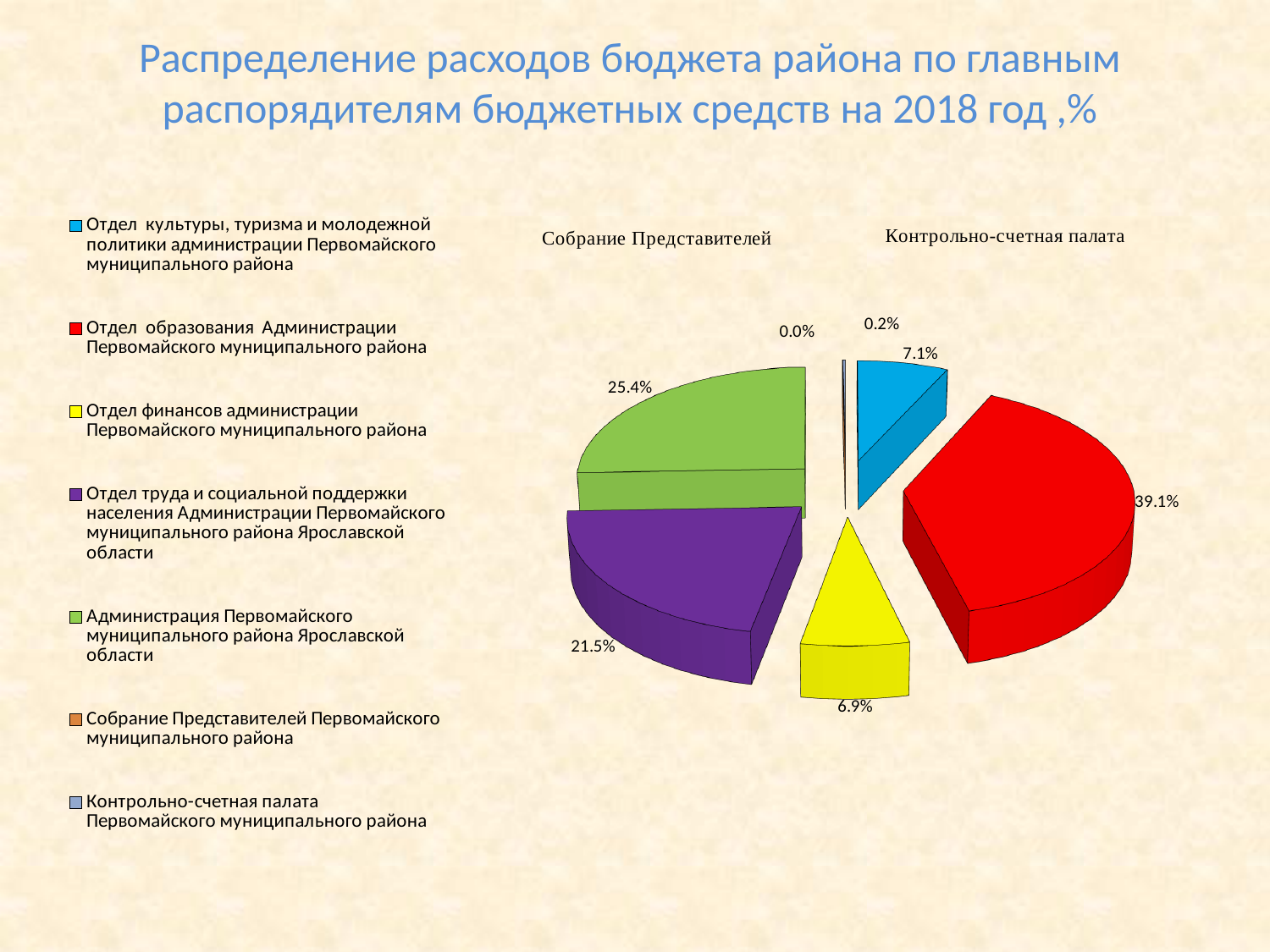
What share is shown for Отдел финансов администрации Первомайского муниципального района? 6.9% What share is shown for Отдел культуры, туризма и молодежной политики? 7.1% Which category has the largest share of the budget expenditure? Отдел образования Администрации Первомайского муниципального района What kind of chart is shown on the slide? Pie chart Which category has the smallest share of the budget expenditure? Собрание Представителей Первомайского муниципального района What is the difference in percentage points between the share of Отдел образования and the share of Администрация Первомайского муниципального района? 13.7 What share of the budget expenditure goes to Отдел образования Администрации Первомайского муниципального района? 39.1% What share is shown for Отдел труда и социальной поддержки населения? 21.5% How many categories does the legend list? 7 What share is shown for Администрация Первомайского муниципального района Ярославской области? 25.4% What share is shown for Контрольно-счетная палата? 0.2% What share is shown for Собрание Представителей? 0.0%